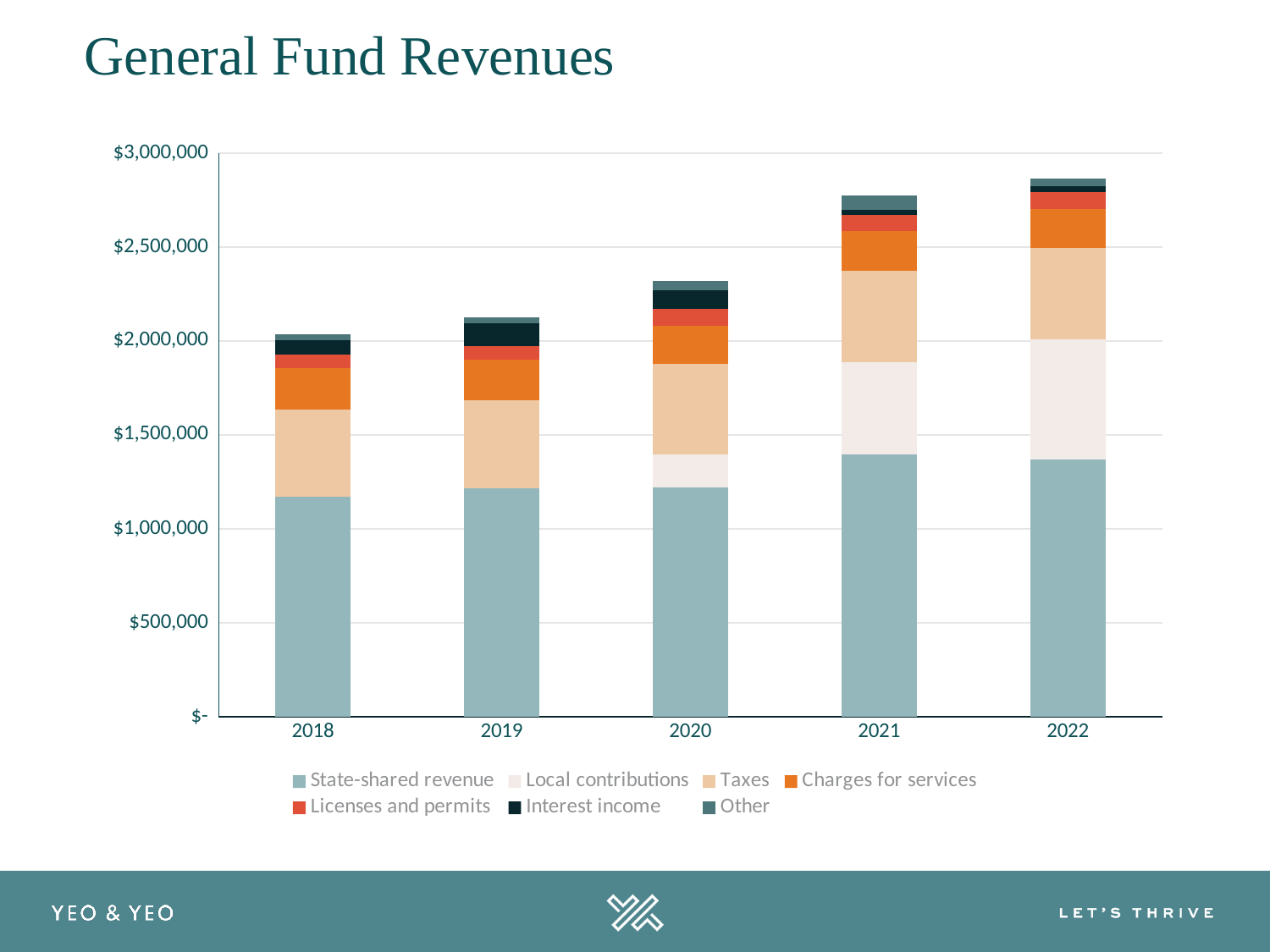
Which series is shown at the bottom of each stacked bar? State-shared revenue How many series does the legend of the General Fund Revenues chart list? 7 What is the title of the chart on the slide? General Fund Revenues Is the total General Fund Revenues for 2020 greater or less than $2,500,000? less How many years are shown on the x axis of the General Fund Revenues chart? 5 Is the State-shared revenue for 2018 greater or less than $1,000,000? greater Do total General Fund Revenues generally rise or fall from 2018 to 2022? rise Is the total General Fund Revenues for 2019 greater or less than $2,000,000? greater What kind of chart is shown on the slide? Stacked bar chart Which year has the lowest total General Fund Revenues? 2018 Which year has the larger total General Fund Revenues, 2019 or 2021? 2021